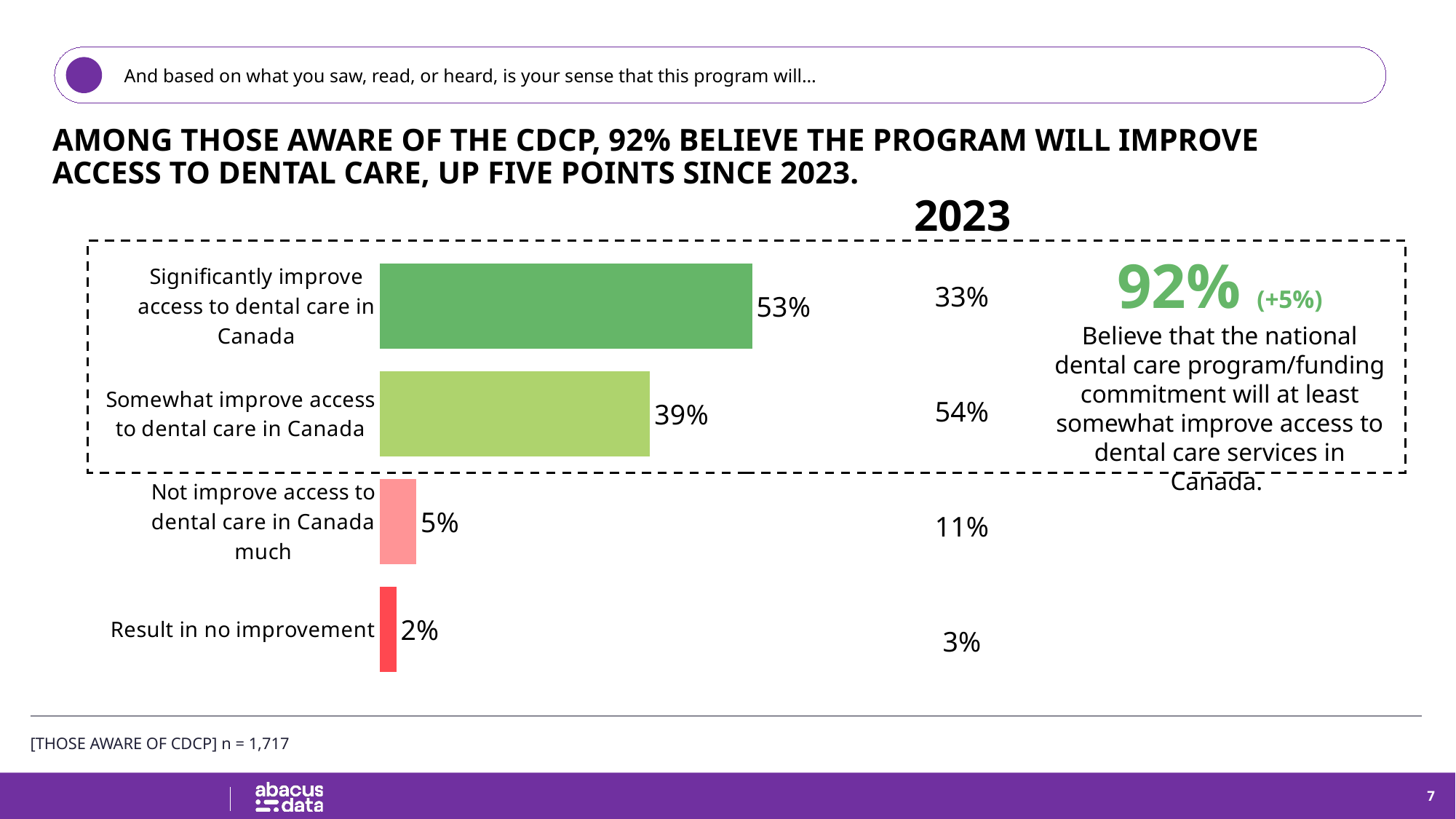
What is the difference between the 'Significantly improve' and 'Somewhat improve' values in the bar chart? 14 percentage points What percentage of respondents said the program will significantly improve access to dental care in Canada? 53% What combined percentage is highlighted as believing the program will at least somewhat improve access to dental care? 92% Which response category has the highest value in the bar chart? Significantly improve access to dental care in Canada What percentage of respondents said the program will somewhat improve access to dental care in Canada? 39% How many response categories are shown in the bar chart? 4 What percentage of respondents said the program will not improve access to dental care in Canada much? 5% Which response category has the lowest value in the bar chart? Result in no improvement What type of chart is shown on the slide? Bar chart What was the 2023 value shown for 'Somewhat improve access to dental care in Canada'? 54% What percentage of respondents said the program will result in no improvement? 2% Which is larger in the bar chart: 'Not improve access to dental care in Canada much' or 'Result in no improvement'? Not improve access to dental care in Canada much